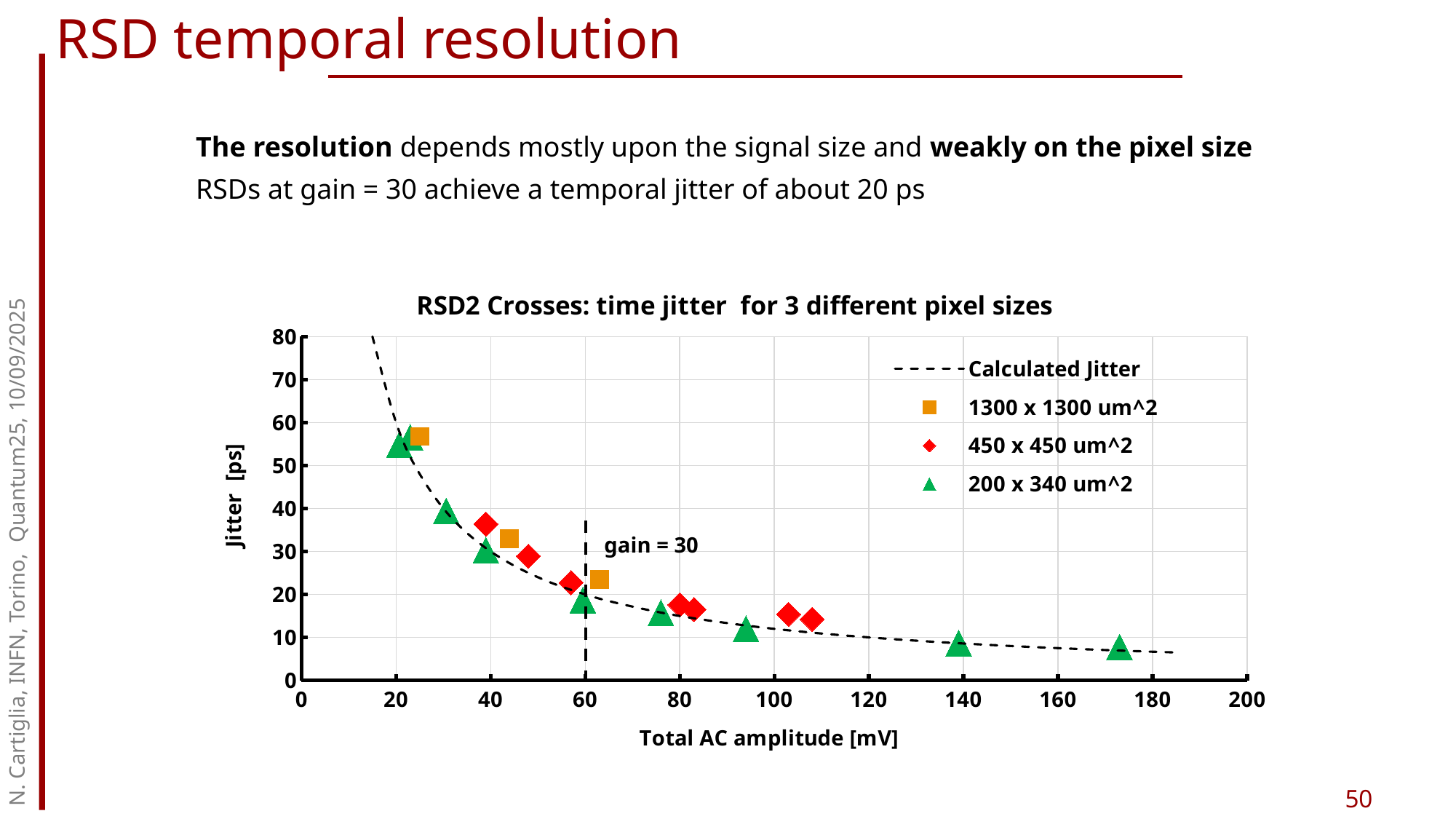
What kind of chart is shown on the slide? scatter chart Is the jitter of the red diamond (450 x 450 um^2) point near 108 mV greater or less than 20 ps? less Is the jitter of the rightmost green triangle (200 x 340 um^2) point greater or less than 10 ps? less What is the title of the chart? RSD2 Crosses: time jitter for 3 different pixel sizes How many red diamond (450 x 450 um^2) data points are plotted? 7 At what total AC amplitude is the vertical dashed 'gain = 30' line drawn? 60 As the total AC amplitude increases, does the jitter rise or fall? fall How many entries does the chart legend list? 4 How many orange square (1300 x 1300 um^2) data points are plotted? 3 Which series has the lowest jitter value on the chart? 200 x 340 um^2 What is the label of the x axis? Total AC amplitude [mV] Is the jitter of the orange square (1300 x 1300 um^2) point near 25 mV greater or less than 50 ps? greater